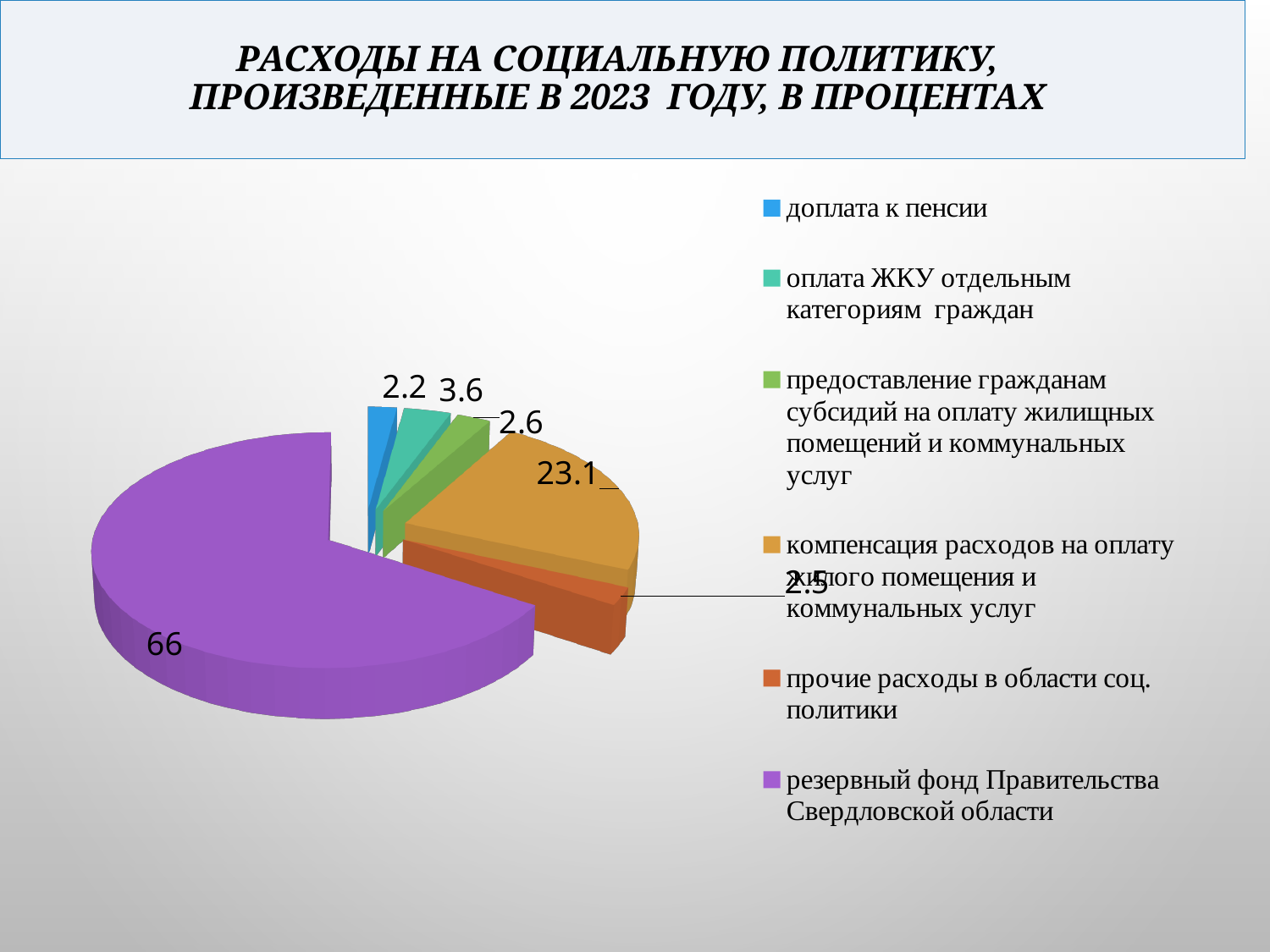
How many categories does the pie chart have? 6 What is the value for "прочие расходы в области соц. политики"? 2.5 Which category has the largest share of the pie? резервный фонд Правительства Свердловской области Which category has the smallest share of the pie? доплата к пенсии What is the value for "компенсация расходов на оплату жилого помещения и коммунальных услуг"? 23.1 What is the value for "доплата к пенсии"? 2.2 What colour is the slice for "компенсация расходов на оплату жилого помещения и коммунальных услуг"? orange Which is larger: the value for "оплата ЖКУ отдельным категориям граждан" or the value for "предоставление гражданам субсидий на оплату жилищных помещений и коммунальных услуг"? оплата ЖКУ отдельным категориям граждан What is the value for "оплата ЖКУ отдельным категориям граждан"? 3.6 What is the difference between the values for "резервный фонд Правительства Свердловской области" and "компенсация расходов на оплату жилого помещения и коммунальных услуг"? 42.9 What kind of chart is shown on the slide? pie chart What is the value for "резервный фонд Правительства Свердловской области"? 66